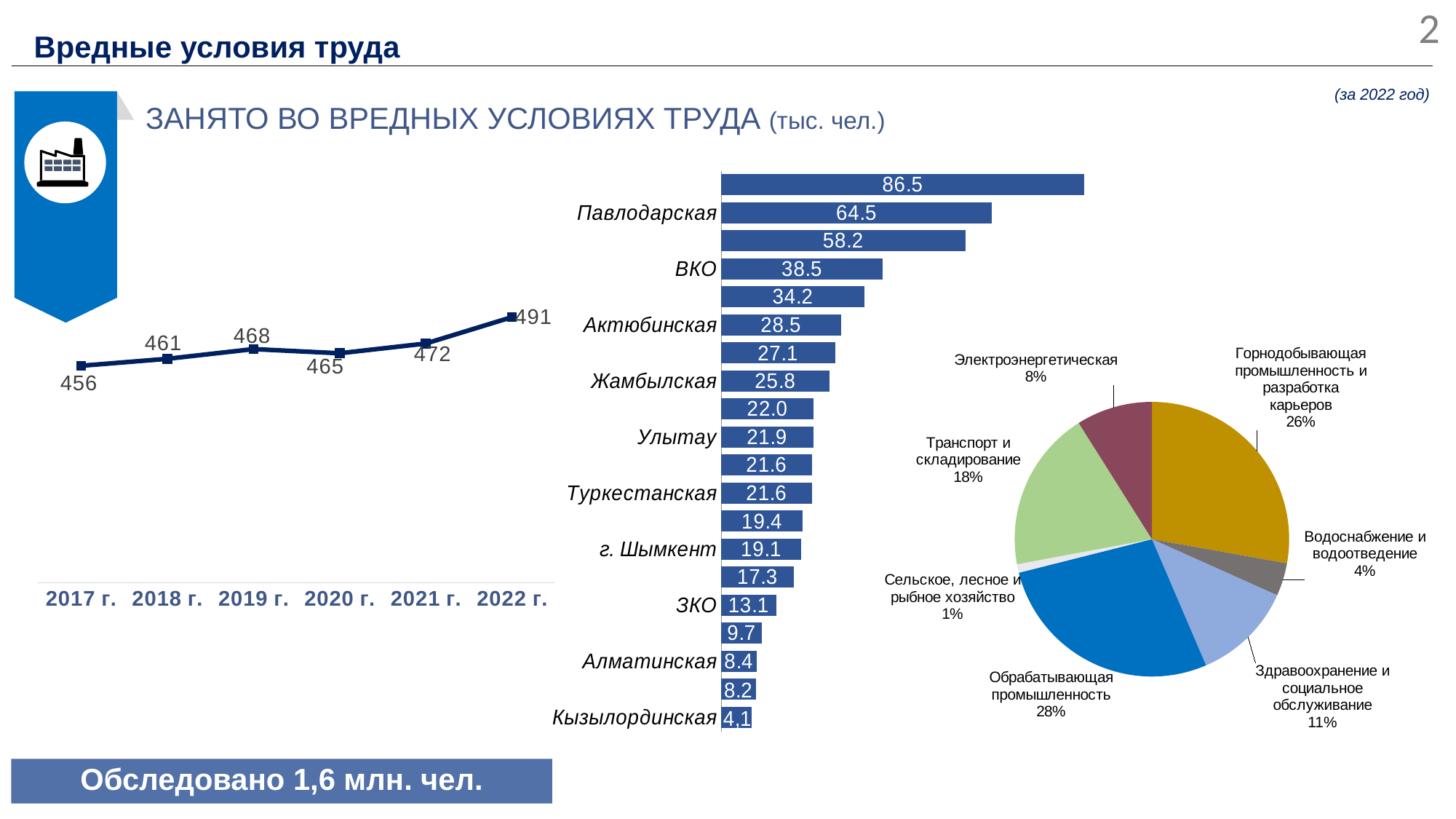
On the line chart, which year has the highest value? 2022 г. On the horizontal bar chart, what is the value for Павлодарская? 64.5 On the horizontal bar chart, which is larger, the value for Актюбинская or the value for ЗКО? Актюбинская On the horizontal bar chart, what is the value for Кызылординская? 4,1 On the pie chart, what share does Обрабатывающая промышленность have? 28% On the pie chart, which category has the smallest share? Сельское, лесное и рыбное хозяйство On the horizontal bar chart, what is the value for ВКО? 38.5 On the line chart, what is the value for 2017 г.? 456 On the line chart, what is the value for 2022 г.? 491 On the line chart, what is the difference between the values for 2022 г. and 2017 г.? 35 What kind of chart is the chart in the middle of the slide showing regions? bar chart On the line chart, how many years are plotted? 6